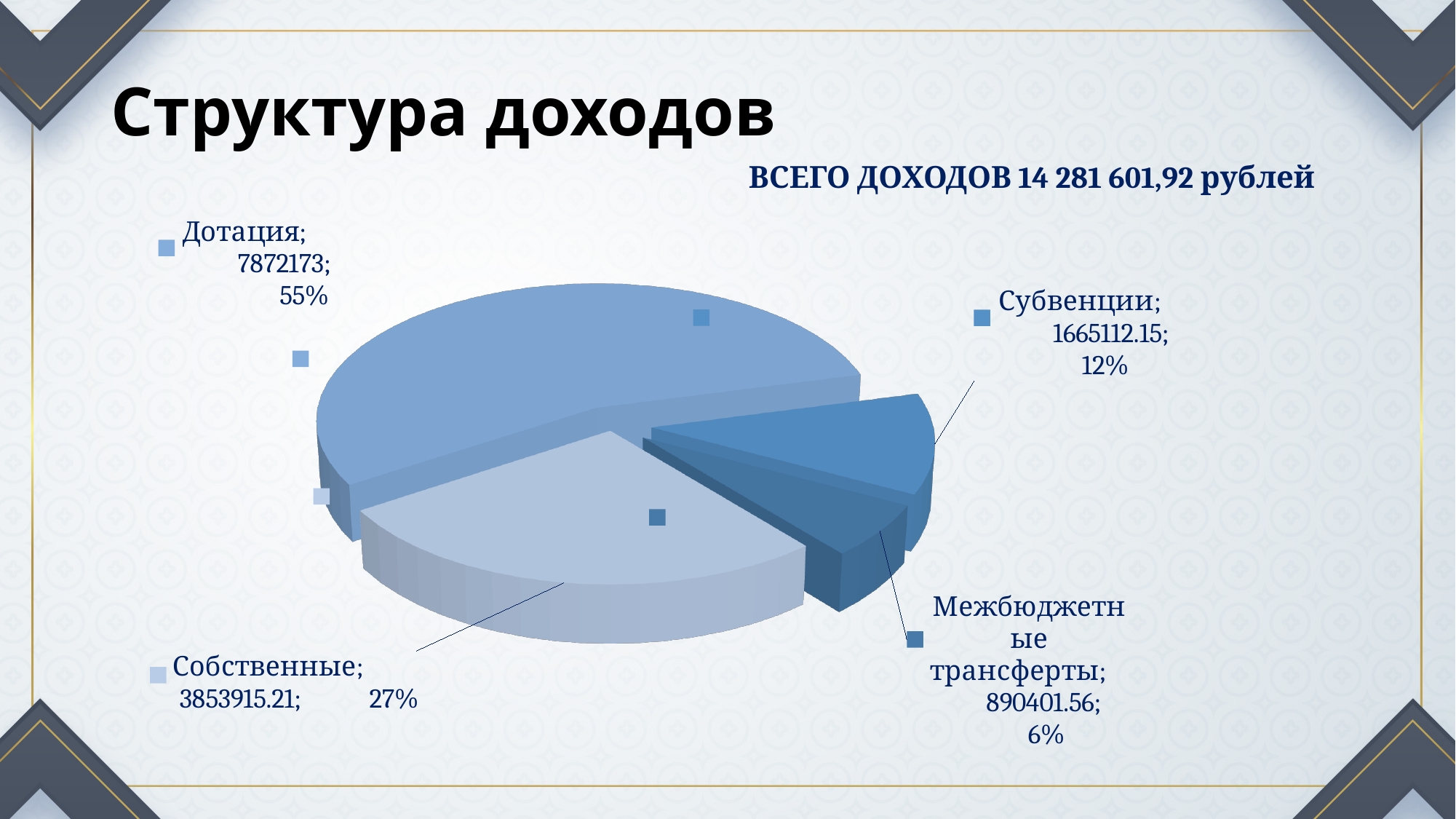
What is the value for Собственные? 3853915.21 What is the value for Субвенции? 1665112.15 What kind of chart is shown on the slide? pie chart What share of the pie does Межбюджетные трансферты represent? 6% What is the value for Межбюджетные трансферты? 890401.56 How many categories are shown in the pie chart? 4 Which category has the smallest slice of the pie? Межбюджетные трансферты Which is larger, Собственные or Субвенции? Собственные What total income is stated above the chart? 14 281 601,92 рублей Which category has the largest slice of the pie? Дотация What is the value for Дотация? 7872173 What share of the pie does Дотация represent? 55%